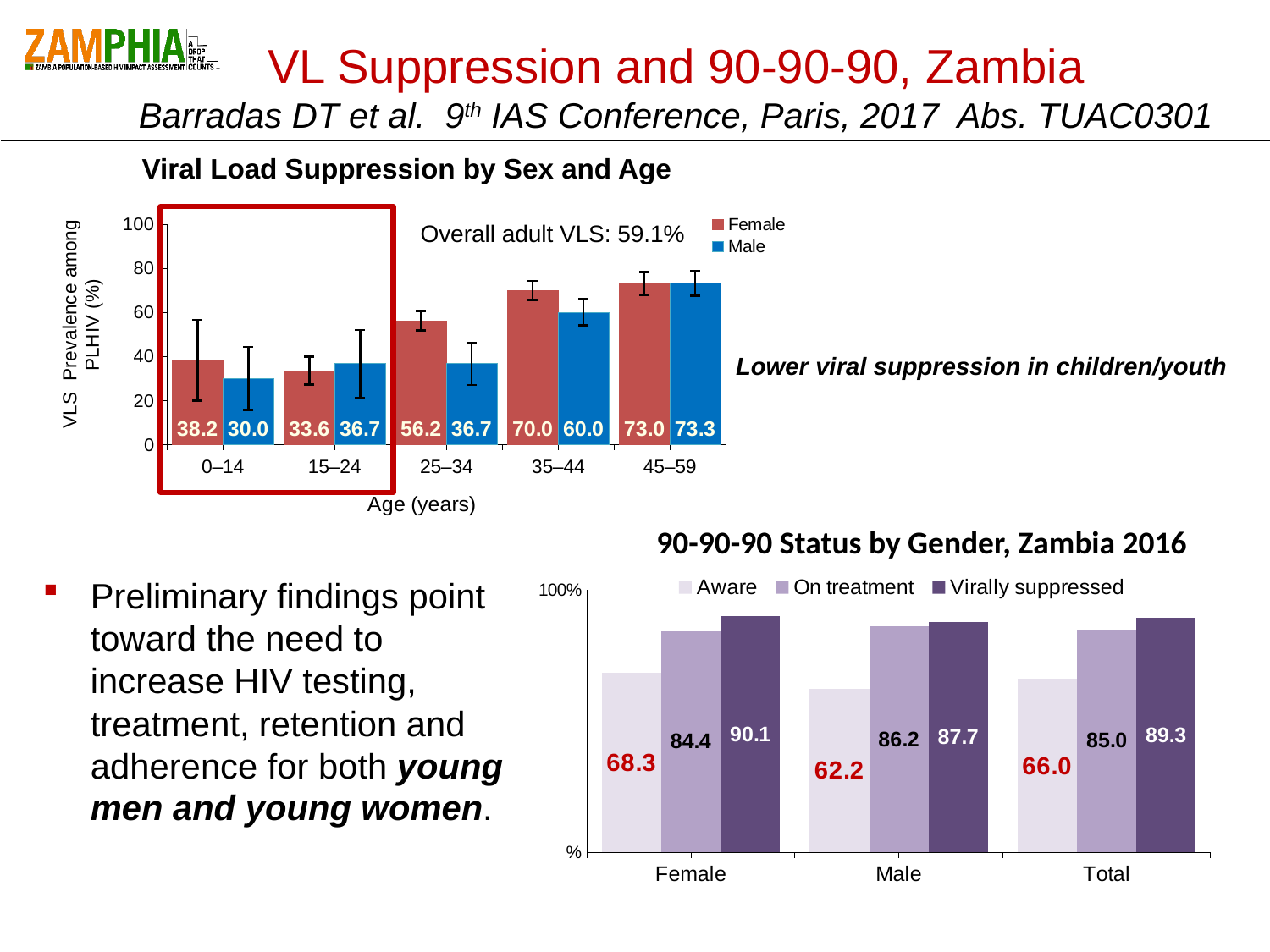
In the 'Viral Load Suppression by Sex and Age' chart, what is the value for Male in the 0–14 age group? 30.0 In the '90-90-90 Status by Gender, Zambia 2016' chart, what is the 'Aware' value for Male? 62.2 In the 'Viral Load Suppression by Sex and Age' chart, which age group has the lowest Male value? 0–14 In the 'Viral Load Suppression by Sex and Age' chart, what is the value for Female in the 25–34 age group? 56.2 In the '90-90-90 Status by Gender, Zambia 2016' chart, which is larger: the 'On treatment' value for Female or for Male? Male In the 'Viral Load Suppression by Sex and Age' chart, what is the difference between the Female and Male values in the 25–34 age group? 19.5 In the 'Viral Load Suppression by Sex and Age' chart, how many age groups are shown on the x axis? 5 What kind of chart is the '90-90-90 Status by Gender, Zambia 2016' chart? Bar chart In the 'Viral Load Suppression by Sex and Age' chart, what overall adult VLS value is stated? 59.1% In the 'Viral Load Suppression by Sex and Age' chart, which age group has the highest Female value? 45–59 In the '90-90-90 Status by Gender, Zambia 2016' chart, how many series does the legend list? 3 In the '90-90-90 Status by Gender, Zambia 2016' chart, what is the 'Virally suppressed' value for Total? 89.3